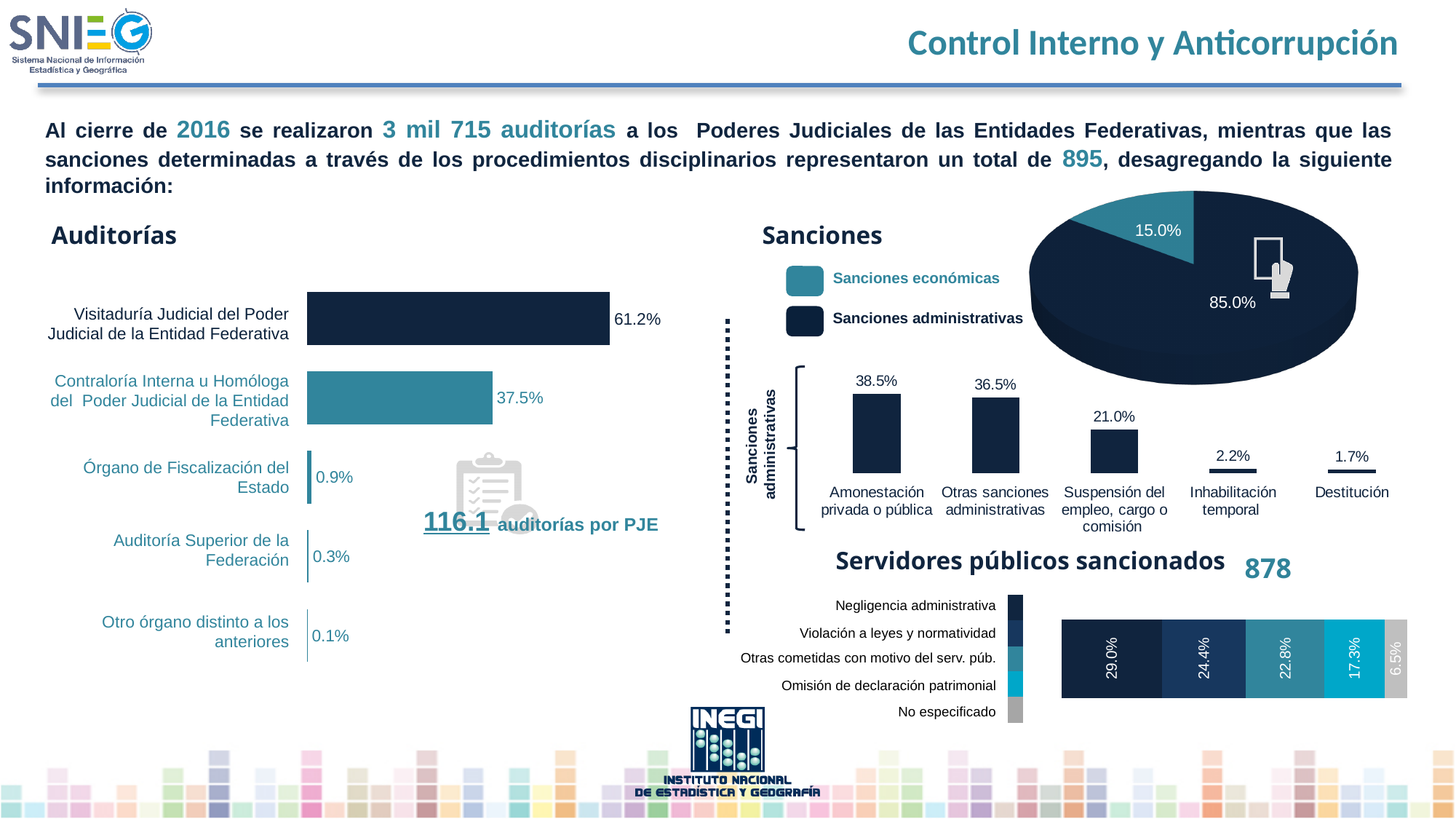
In the Auditorías bar chart, what is the difference between Visitaduría Judicial del Poder Judicial de la Entidad Federativa and Contraloría Interna u Homóloga del Poder Judicial de la Entidad Federativa? 23.7% In the Sanciones administrativas bar chart, what is the difference between Inhabilitación temporal and Destitución? 0.5% How many categories does the Auditorías bar chart show? 5 In the Servidores públicos sancionados stacked bar, what is the value for Omisión de declaración patrimonial? 17.3% In the Sanciones administrativas bar chart, what is the value for Suspensión del empleo, cargo o comisión? 21.0% In the Sanciones pie chart, what share do Sanciones económicas represent? 15.0% What kind of chart is used for Sanciones económicas and Sanciones administrativas? Pie chart In the Sanciones pie chart, which slice is larger, Sanciones económicas or Sanciones administrativas? Sanciones administrativas In the Sanciones administrativas bar chart, which category has the highest value? Amonestación privada o pública How many series does the legend of the Servidores públicos sancionados chart list? 5 In the Auditorías bar chart, which category has the lowest value? Otro órgano distinto a los anteriores In the Auditorías bar chart, what is the value for Visitaduría Judicial del Poder Judicial de la Entidad Federativa? 61.2%